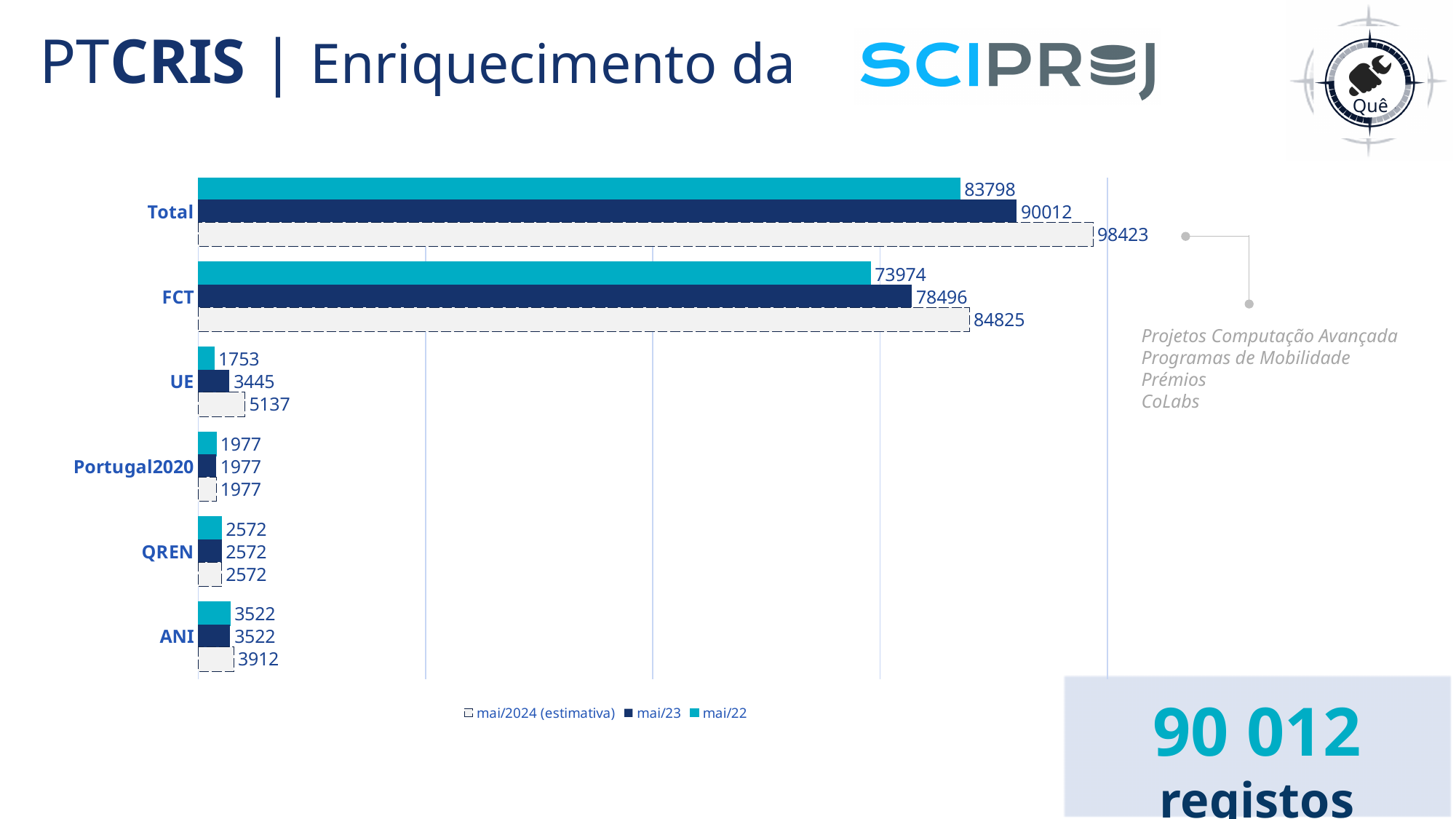
Excluding Total, which category has the lowest mai/2024 (estimativa) value? Portugal2020 How many series does the legend list? 3 Which series is shown in the lightest (dashed-outline) bars? mai/2024 (estimativa) What is the mai/23 value for FCT? 78496 What is the mai/22 value for UE? 1753 What kind of chart is shown on the slide? bar chart What is the mai/2024 (estimativa) value for Total? 98423 Which is larger, the mai/23 value for UE or the mai/23 value for ANI? ANI Excluding Total, which category has the highest mai/22 value? FCT How many categories are shown on the chart? 6 What is the difference between the mai/23 and mai/22 values for Total? 6214 What is the mai/2024 (estimativa) value for ANI? 3912